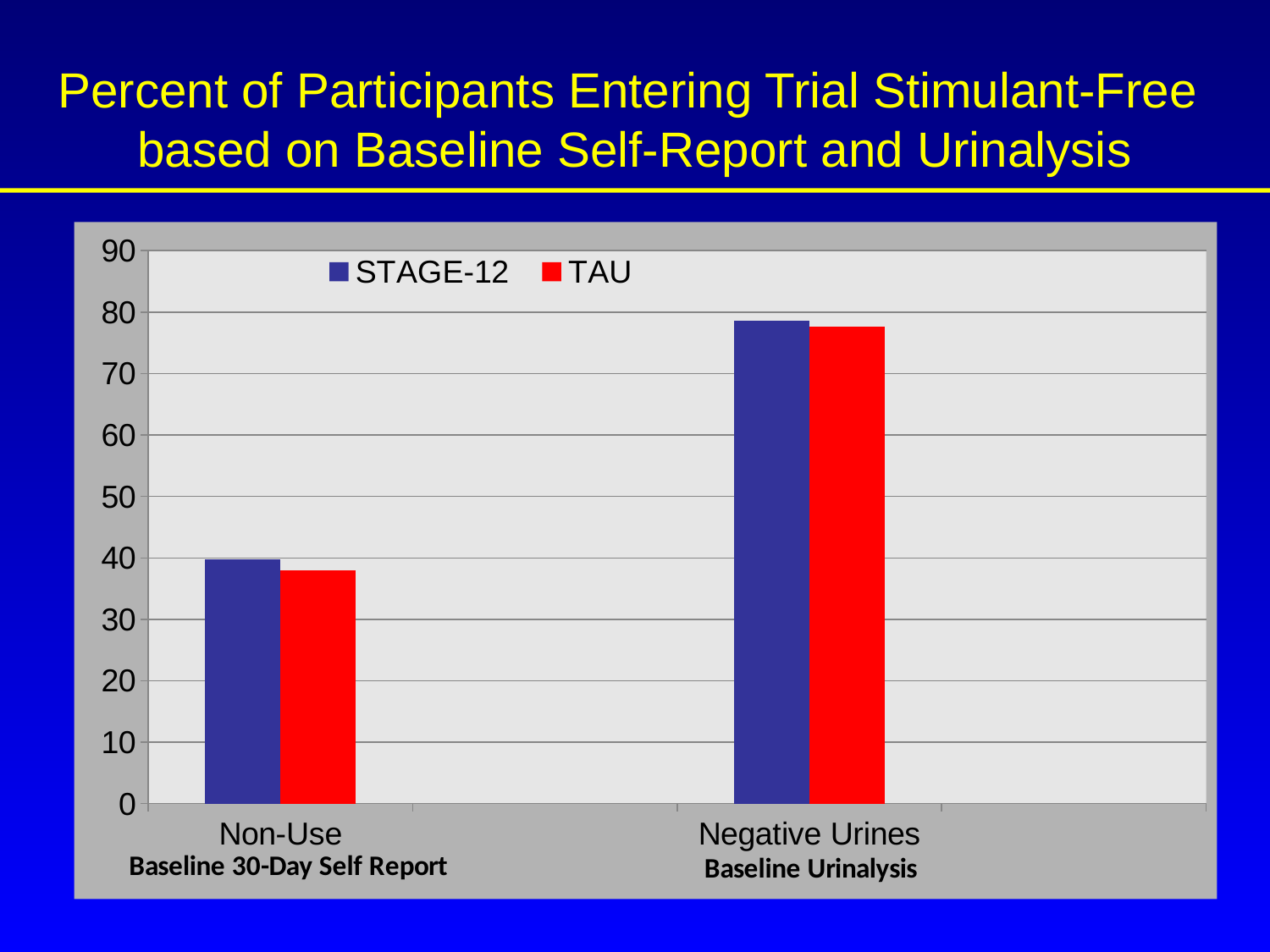
Is the TAU value for Non-Use greater or less than 30? greater For the STAGE-12 series, which category has the higher value: Non-Use or Negative Urines? Negative Urines What is the title of the chart on the slide? Percent of Participants Entering Trial Stimulant-Free based on Baseline Self-Report and Urinalysis Which series is shown in red in the legend? TAU For the TAU series, which category has the lowest value? Non-Use How many categories are shown on the x axis? 2 Is the TAU value for Negative Urines greater or less than 80? less In the Non-Use category, which series has the larger value: STAGE-12 or TAU? STAGE-12 Is the STAGE-12 value for Negative Urines greater or less than 70? greater How many series does the legend list? 2 What kind of chart is shown on the slide? bar chart